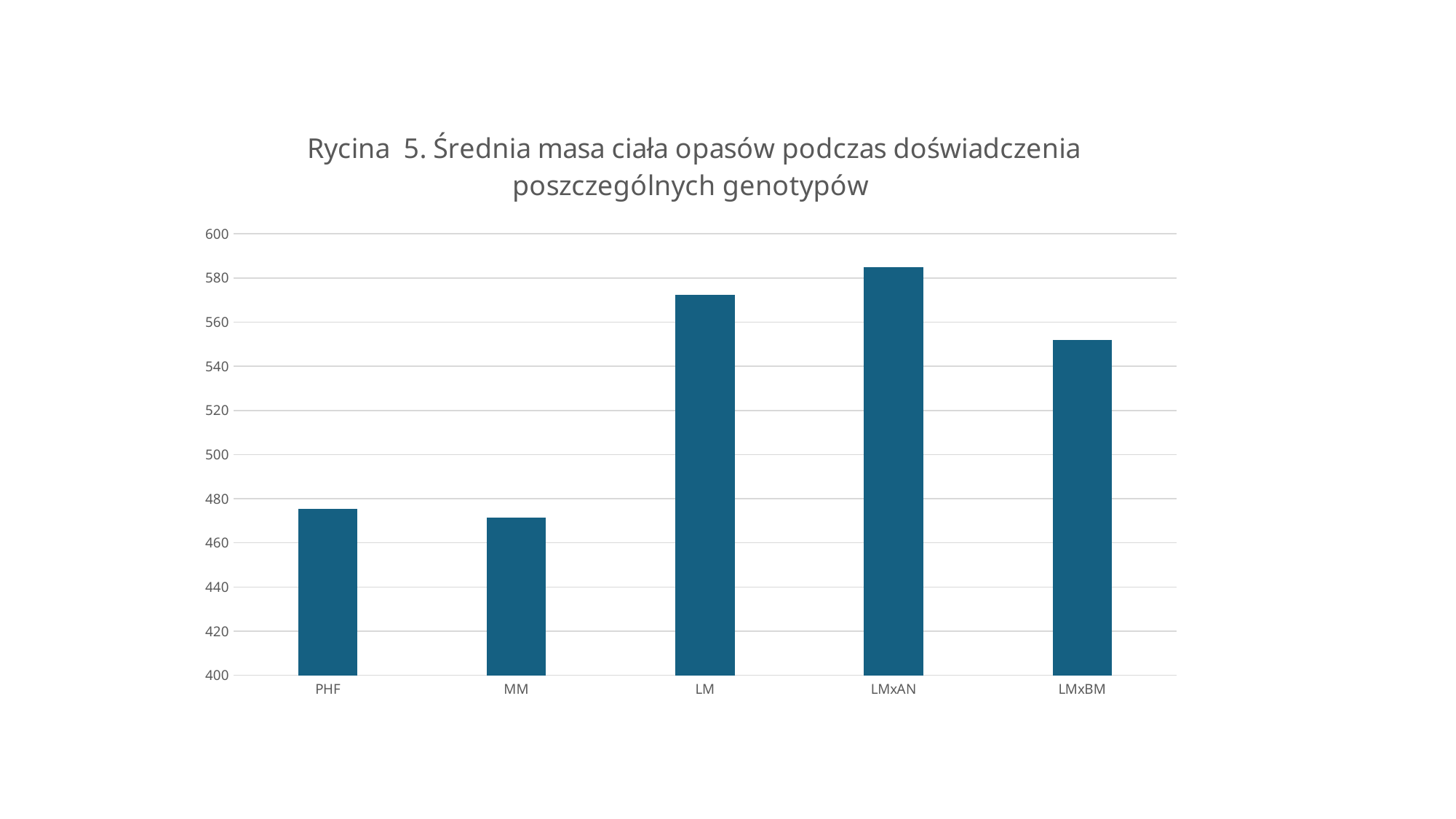
What is the lowest value shown on the vertical axis? 400 Which is larger, the value for LM or the value for LMxBM? LM Is the value for MM greater or less than 460? greater Which is larger, the value for MM or the value for LMxAN? LMxAN Which genotype has the highest average body mass? LMxAN How many genotype categories are plotted on the chart? 5 What kind of chart is shown on the slide? bar chart Is the value for PHF greater or less than 480? less Is the value for LMxAN greater or less than 580? greater What is the title of the chart? Rycina 5. Średnia masa ciała opasów podczas doświadczenia poszczególnych genotypów